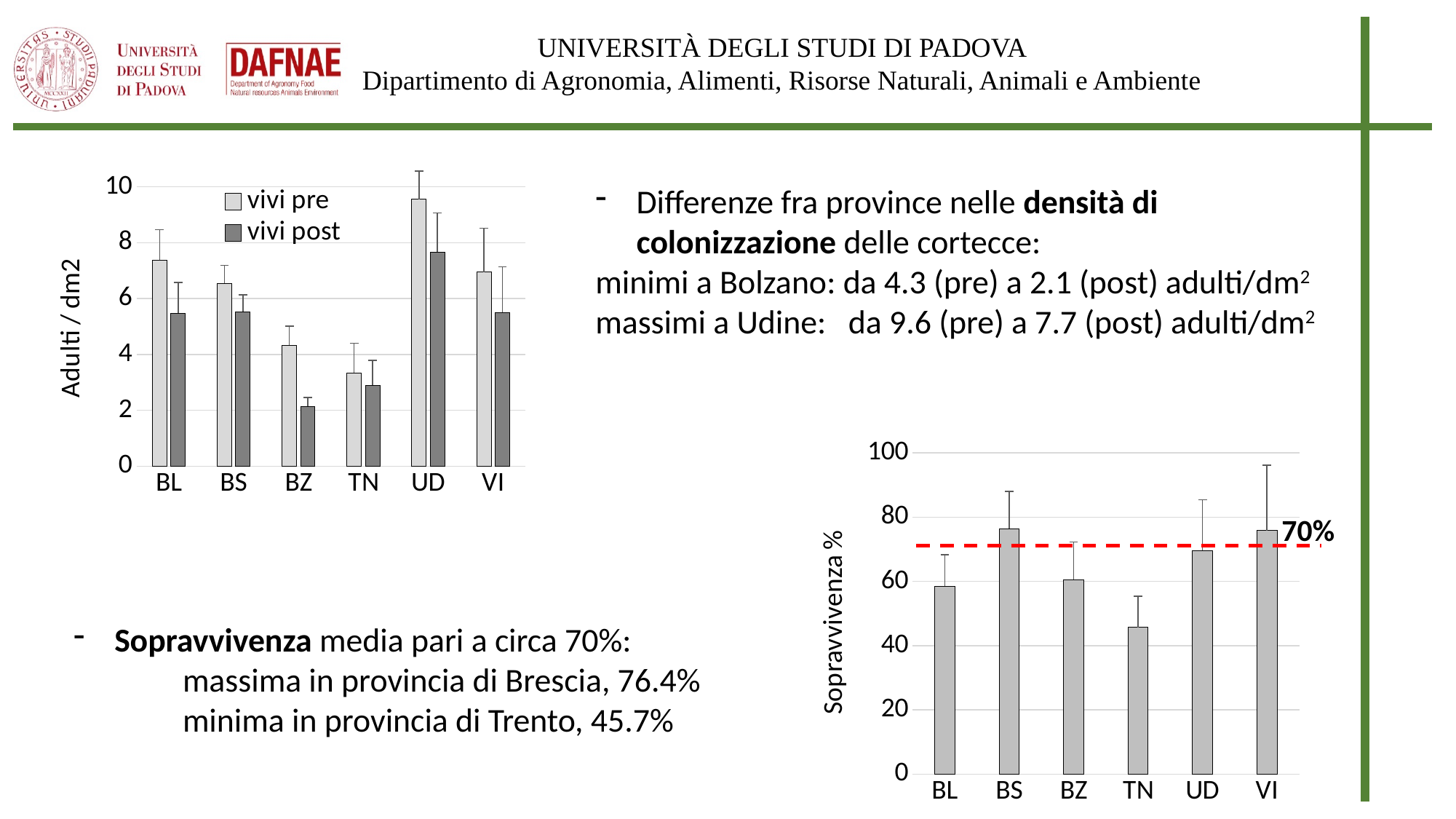
In the left chart (Adulti / dm2), which province has the lowest 'vivi post' value? BZ What kind of chart is the left chart (Adulti / dm2)? bar chart In the left chart (Adulti / dm2), which is larger for BL: 'vivi pre' or 'vivi post'? vivi pre In the right chart (Sopravvivenza %), what value does the red dashed line mark? 70% In the left chart (Adulti / dm2), is the 'vivi pre' value for BL greater or less than 6? greater In the right chart (Sopravvivenza %), what is the survival value for BS as stated on the slide? 76.4% In the right chart (Sopravvivenza %), which province has the highest survival? BS How many series does the legend of the left chart (Adulti / dm2) list? 2 In the left chart (Adulti / dm2), which province has the highest 'vivi pre' value? UD How many provinces are shown on the x axis of the left chart (Adulti / dm2)? 6 In the right chart (Sopravvivenza %), is the value for TN greater or less than 60? less In the right chart (Sopravvivenza %), which province has the lowest survival? TN